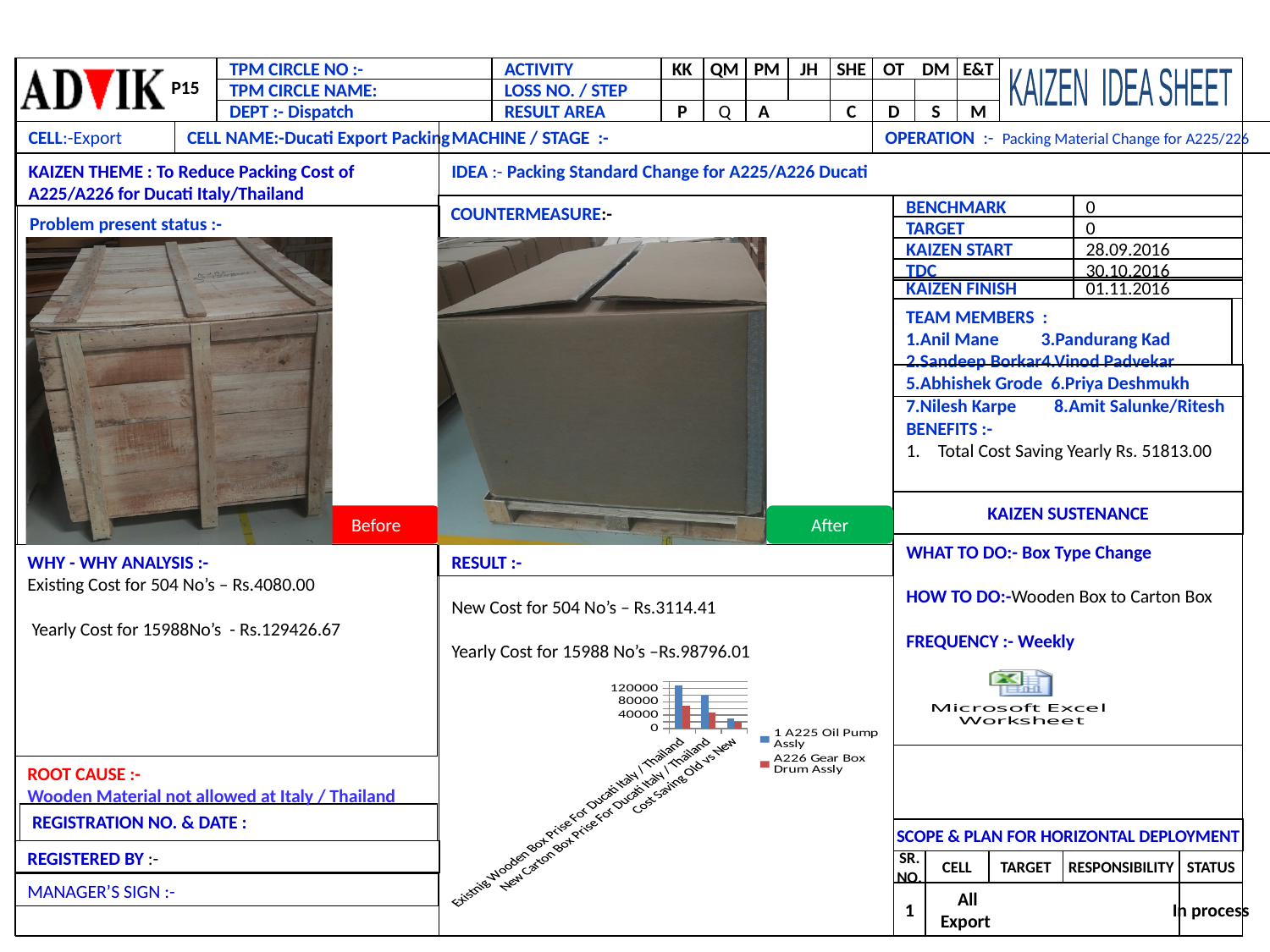
In the chart in the RESULT section, which is larger for 1 A225 Oil Pump Assly: the Existnig Wooden Box Prise or the New Carton Box Prise? Existnig Wooden Box Prise What is the highest tick value shown on the y axis of the chart in the RESULT section? 120000 In the chart in the RESULT section, is the value for 1 A225 Oil Pump Assly in the Cost Saving Old vs New category greater or less than 40000? less In the chart in the RESULT section, do the values for 1 A225 Oil Pump Assly rise or fall from left to right along the x axis? fall In the chart in the RESULT section, is the value for 1 A225 Oil Pump Assly in the Existnig Wooden Box Prise category greater or less than 80000? greater In the chart in the RESULT section, which category has the lowest value for 1 A225 Oil Pump Assly? Cost Saving Old vs New In the chart in the RESULT section, within the Existnig Wooden Box Prise category, which series has the larger value: 1 A225 Oil Pump Assly or A226 Gear Box Drum Assly? 1 A225 Oil Pump Assly What are the two legend entries of the chart in the RESULT section? 1 A225 Oil Pump Assly; A226 Gear Box Drum Assly In the chart in the RESULT section, which category has the highest value for 1 A225 Oil Pump Assly? Existnig Wooden Box Prise For Ducati Italy / Thailand How many categories are shown along the x axis of the chart in the RESULT section? 3 What kind of chart is shown in the RESULT section of the slide? bar chart How many series does the legend of the chart in the RESULT section list? 2